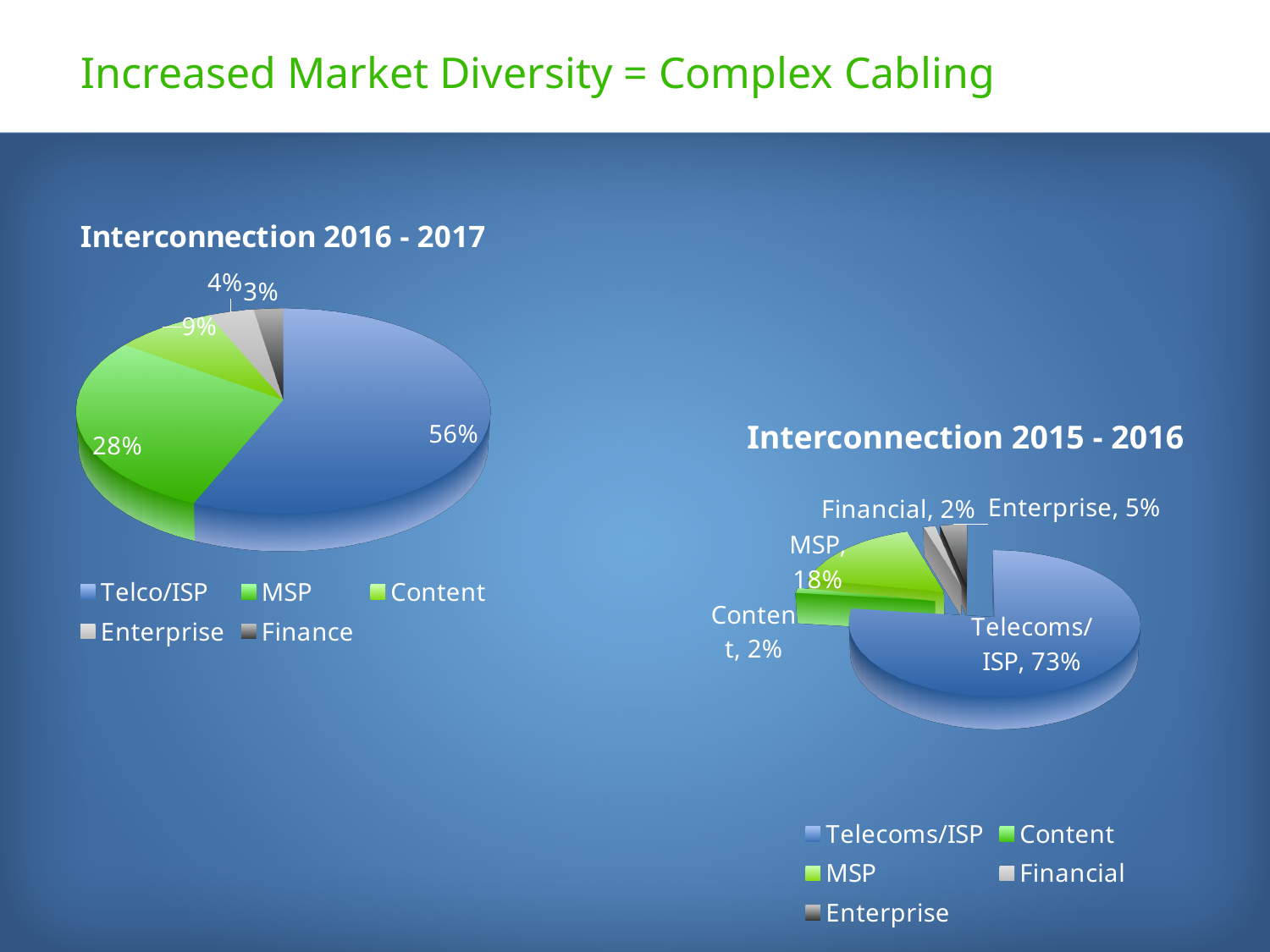
In the Interconnection 2016 - 2017 chart, which category has the largest slice? Telco/ISP In the Interconnection 2016 - 2017 chart, what share does Telco/ISP have? 56% What type of chart is the Interconnection 2016 - 2017 chart? Pie chart In the Interconnection 2015 - 2016 chart, what share does Enterprise have? 5% In the Interconnection 2015 - 2016 chart, what share does MSP have? 18% In the Interconnection 2016 - 2017 chart, what is the difference between the Telco/ISP share and the MSP share? 28% In the Interconnection 2016 - 2017 chart, what share does MSP have? 28% How many categories does the legend of the Interconnection 2015 - 2016 chart list? 5 In the Interconnection 2015 - 2016 chart, what is the difference between the Telecoms/ISP share and the MSP share? 55% In the Interconnection 2015 - 2016 chart, which is larger, the MSP share or the Enterprise share? MSP In the Interconnection 2015 - 2016 chart, which category has the largest slice? Telecoms/ISP In the Interconnection 2015 - 2016 chart, what share does Telecoms/ISP have? 73%